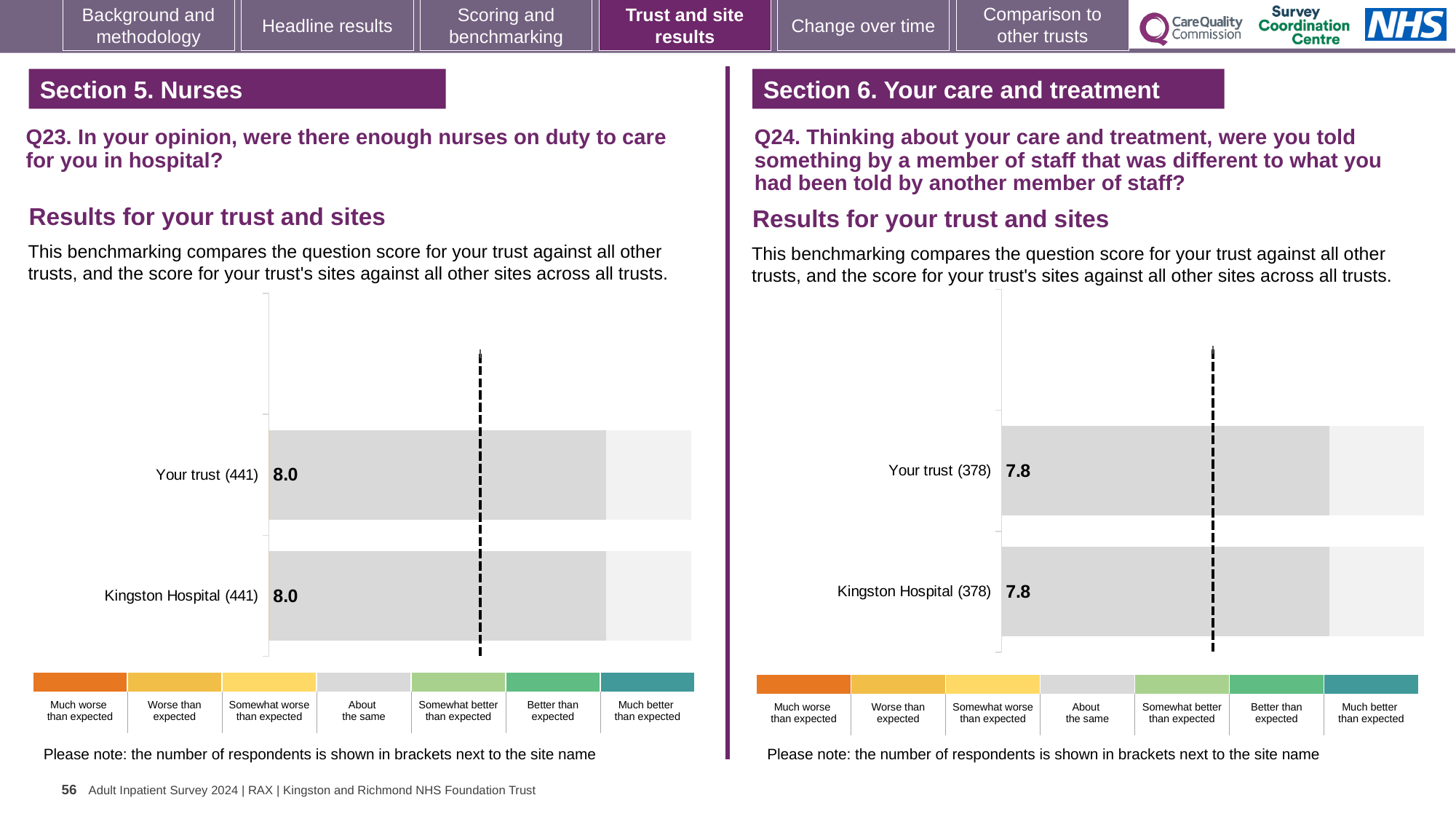
On the Q24 chart (right), which benchmark category do both bars fall into according to the colour key? About the same On the Q23 chart (left), what is the score for Your trust? 8.0 How many categories does the colour key below the Q23 chart (left) list? 7 On the Q23 chart (left), what is the difference between the score for Your trust and the score for Kingston Hospital? 0.0 What kind of chart is the Q23 chart (left)? Bar chart On the Q24 chart (right), what is the score for Your trust? 7.8 On the Q23 chart (left), how many respondents are shown in brackets next to Kingston Hospital? 441 On the Q24 chart (right), how many bars are plotted? 2 On the Q24 chart (right), how many respondents are shown in brackets next to Your trust? 378 Is the score for Your trust on the Q23 chart (left) higher or lower than the score for Your trust on the Q24 chart (right)? Higher On the Q23 chart (left), what is the score for Kingston Hospital? 8.0 On the Q24 chart (right), what is the score for Kingston Hospital? 7.8